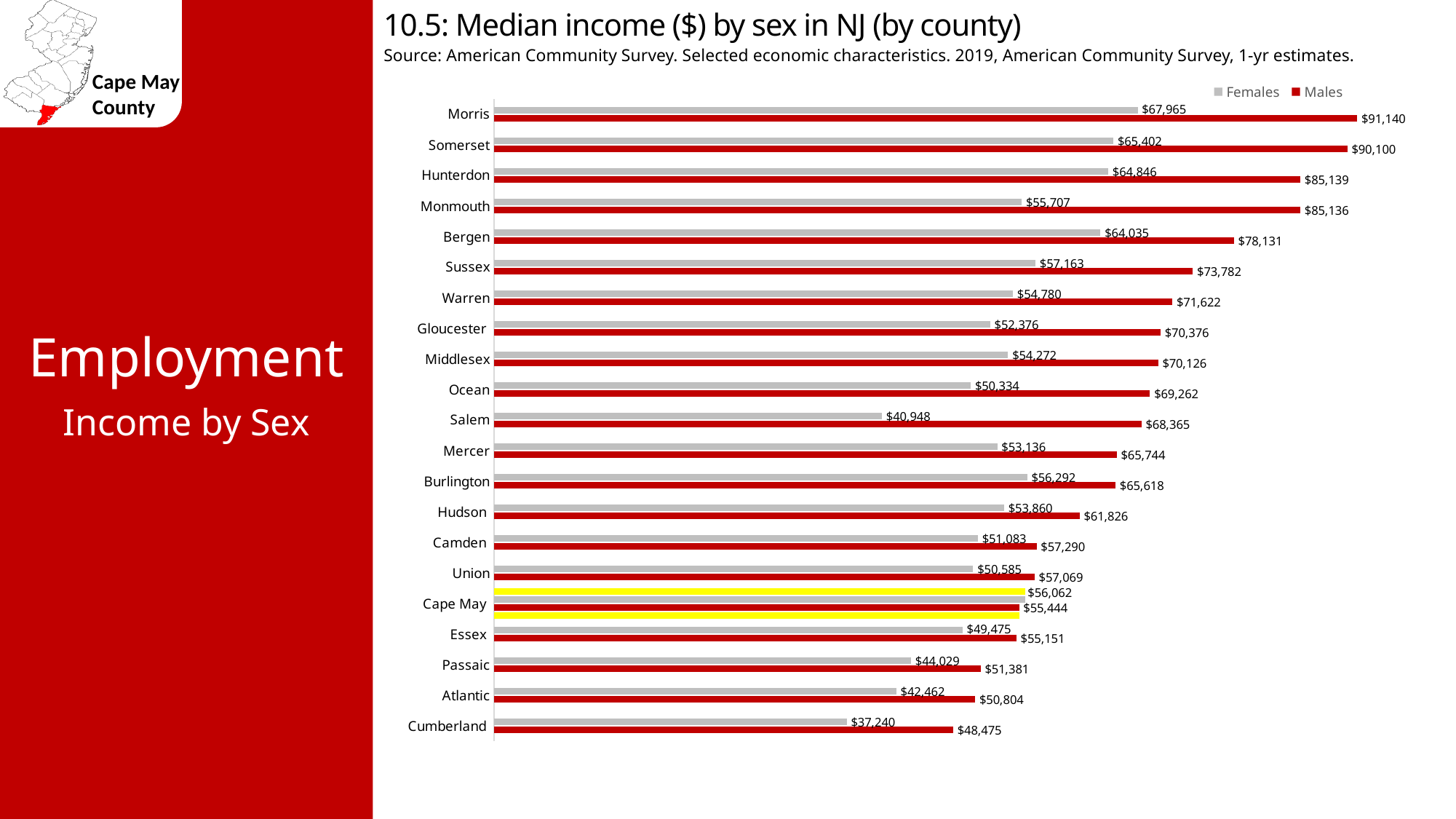
Which county's bars are highlighted in yellow? Cape May What is the difference between the Males and Females median income in Morris county? $23,175 What is the median income for Females in Salem county? $40,948 What kind of chart is shown on the slide? Bar chart In Cape May county, which is larger: the Females or the Males median income? Females How many counties are shown in the chart? 21 Which county has the highest median income for Males? Morris What is the median income for Females in Cape May county? $56,062 What is the difference between the Females and Males median income in Cape May county? $618 What is the median income for Males in Morris county? $91,140 Which county has the lowest median income for Females? Cumberland How many series does the legend list? 2